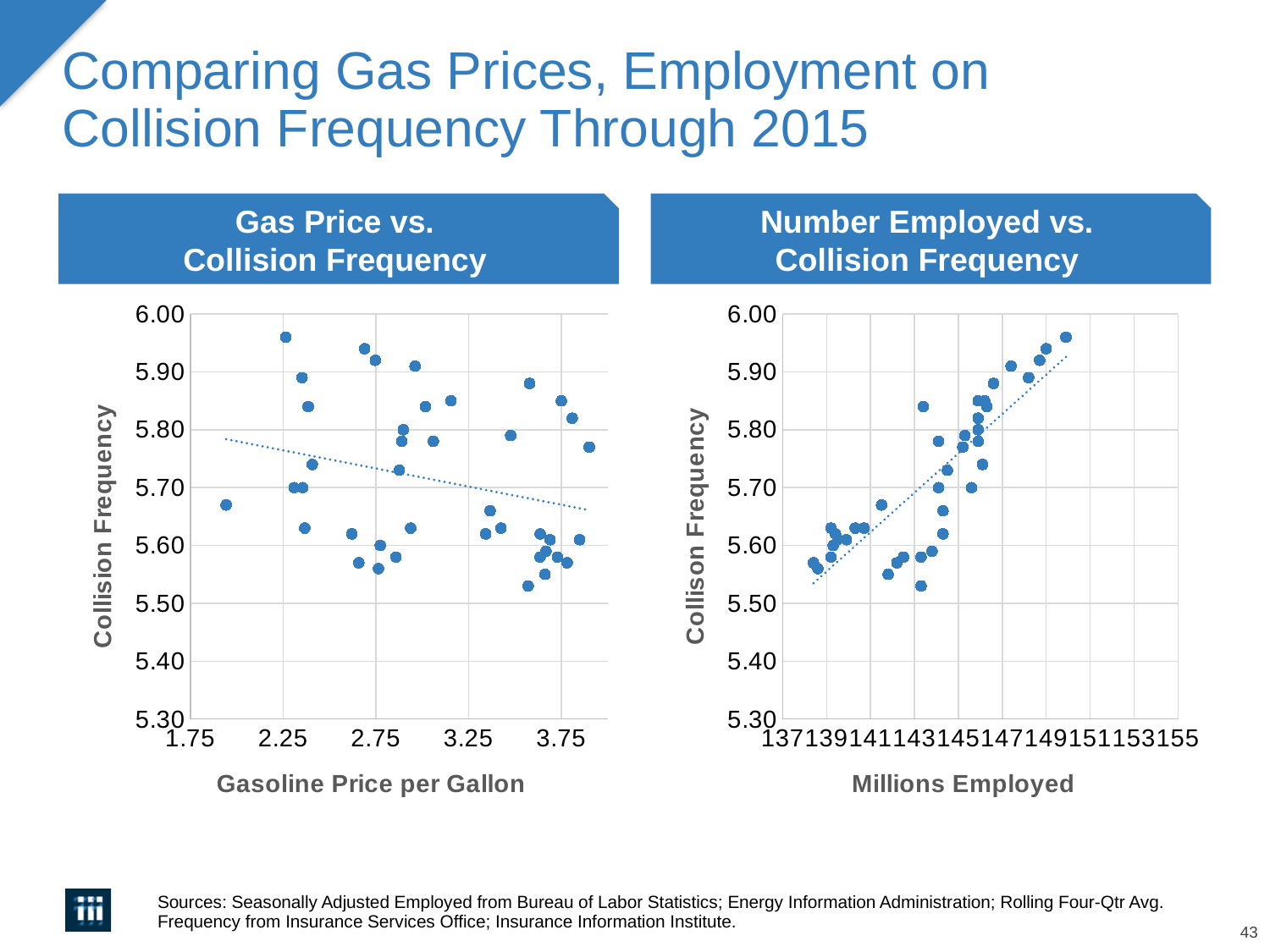
In the "Gas Price vs. Collision Frequency" chart, is the collision frequency of the lowest point greater or less than 5.60? less In the "Number Employed vs. Collision Frequency" chart, is the collision frequency of the leftmost point greater or less than 5.60? less In the "Gas Price vs. Collision Frequency" chart, is the collision frequency of the leftmost point greater or less than 5.60? greater In the "Number Employed vs. Collision Frequency" chart, does the dotted trend line rise or fall as millions employed increases? Rise What kind of chart is the "Gas Price vs. Collision Frequency" chart? Scatter chart In the "Gas Price vs. Collision Frequency" chart, does the dotted trend line rise or fall as gasoline price increases? Fall What kind of chart is the "Number Employed vs. Collision Frequency" chart? Scatter chart What is the x-axis title of the "Gas Price vs. Collision Frequency" chart? Gasoline Price per Gallon What is the x-axis title of the "Number Employed vs. Collision Frequency" chart? Millions Employed